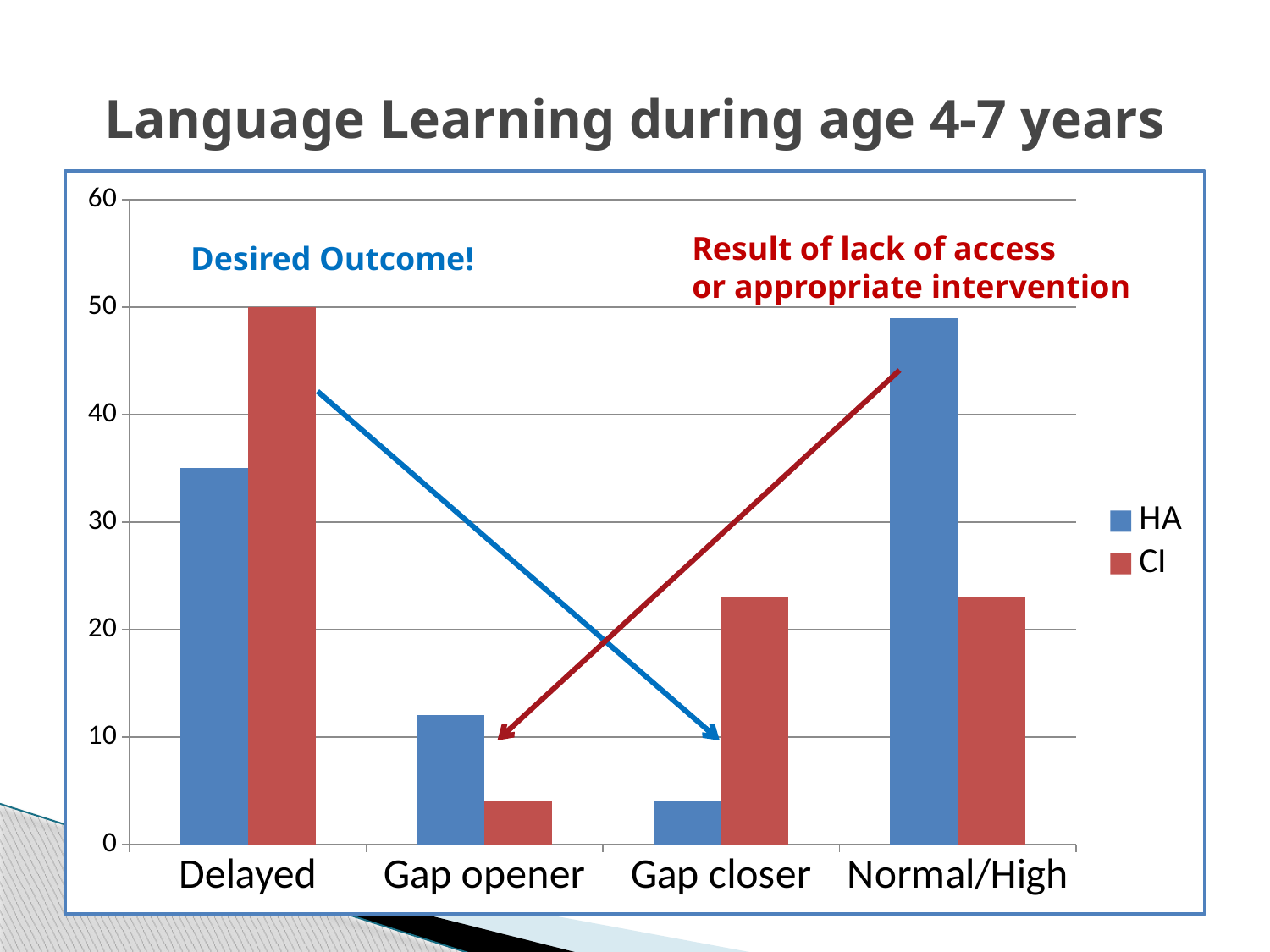
Is the CI value for Gap opener greater or less than 10? less Which category has the lowest CI value? Gap opener In the Delayed category, which is larger, HA or CI? CI What type of chart is shown on the slide? bar chart How many categories are shown on the x axis? 4 What is the CI value for the Delayed category? 50 Which category has the highest CI value? Delayed What is the title of the chart? Language Learning during age 4-7 years Is the HA value for Delayed greater or less than 30? greater Which category has the highest HA value? Normal/High Which category has the lowest HA value? Gap closer How many series does the legend list? 2